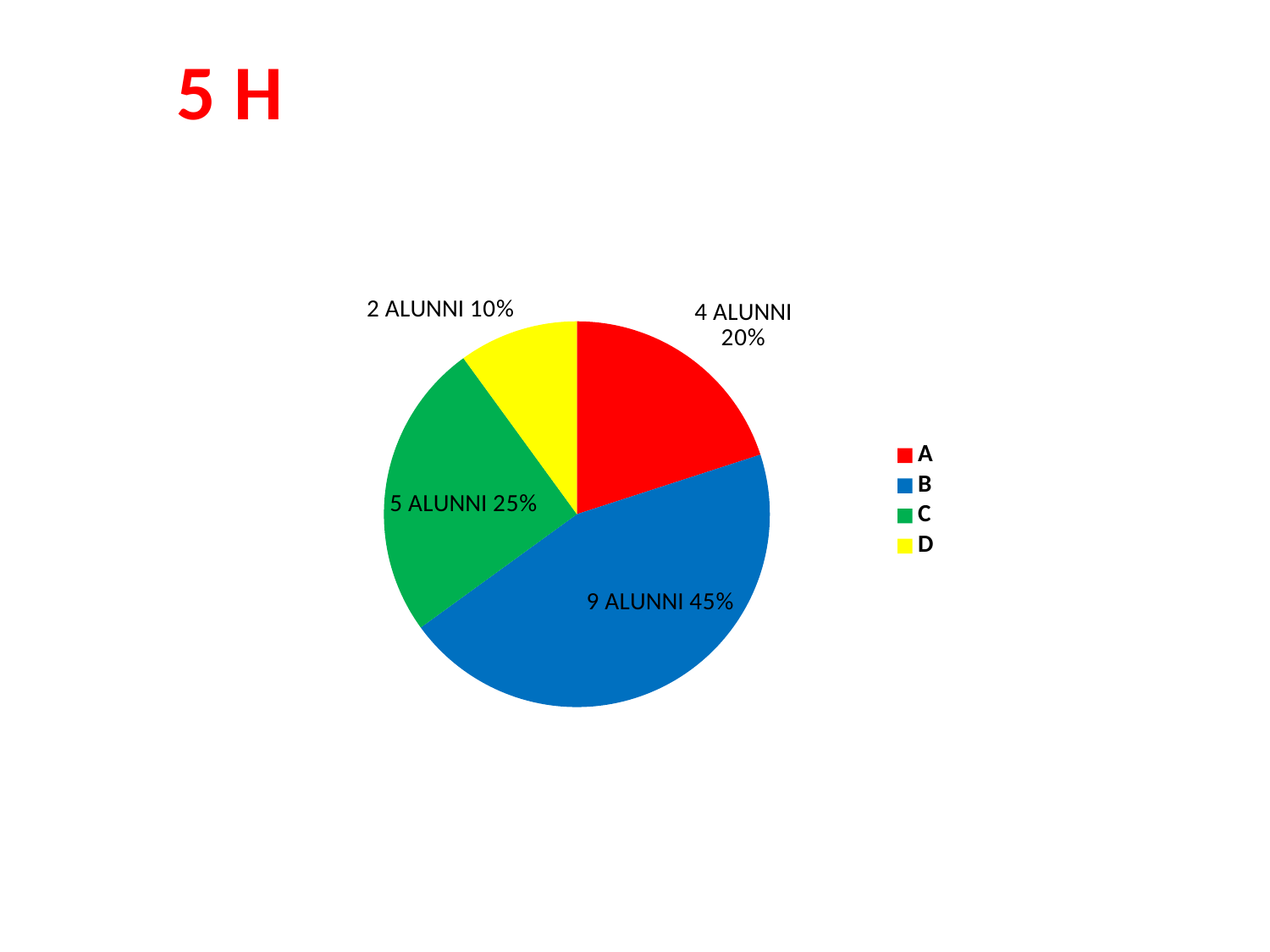
How many alunni are in category A? 4 ALUNNI What percentage share does category D have? 10% Which is larger, the slice for A or the slice for C? C What percentage share does category B have? 45% How many alunni are in category C? 5 ALUNNI What kind of chart is shown on the slide? pie chart What is the total number of alunni across all slices? 20 What is the difference in percentage between category B and category C? 20% Which category has the largest slice? B How many categories does the pie chart have? 4 Which category has the smallest slice? D What colour is the slice for category B? blue